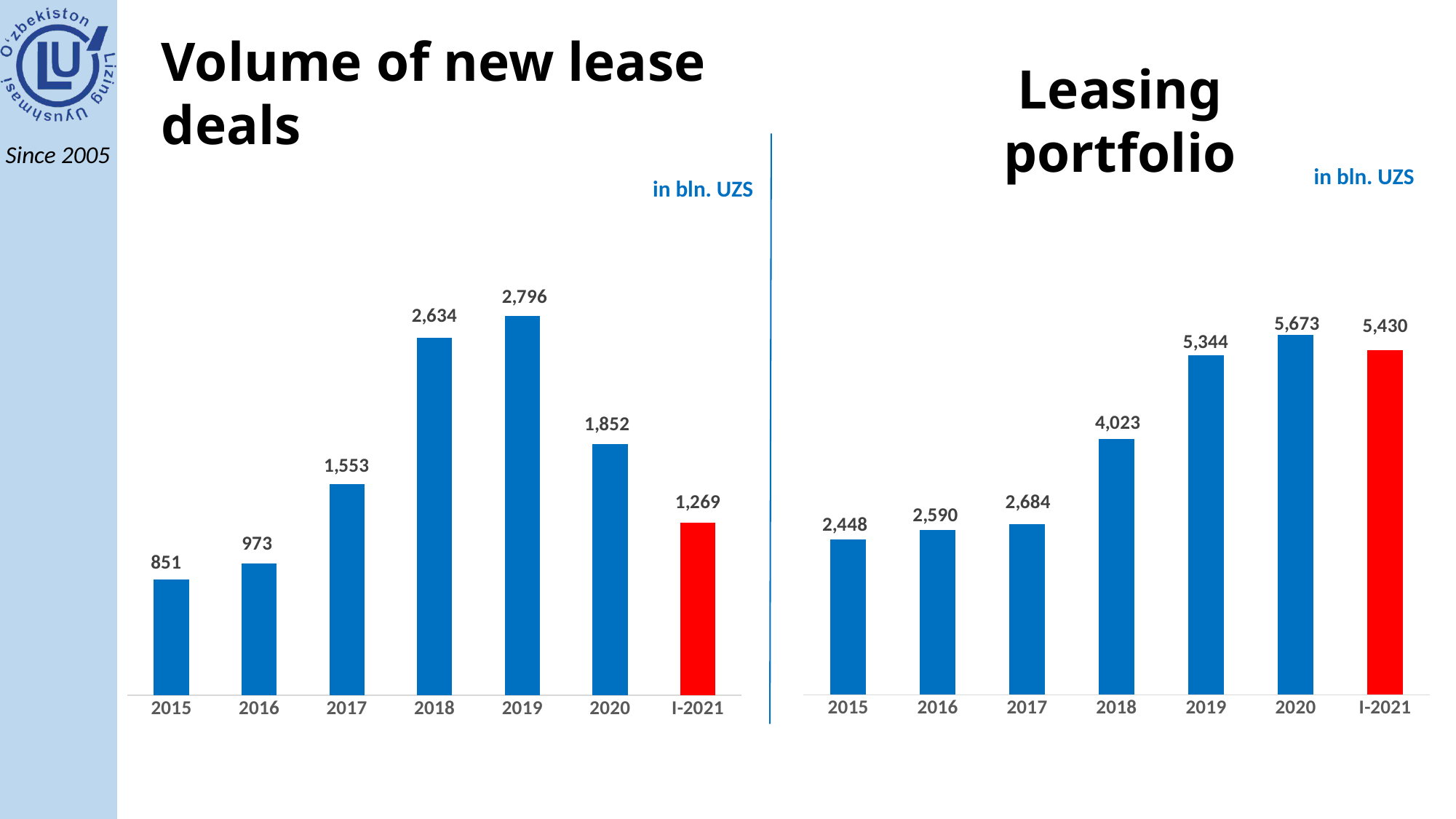
In the 'Volume of new lease deals' chart, what is the value for 2019? 2,796 In the 'Leasing portfolio' chart, which year has the lowest value? 2015 In the 'Leasing portfolio' chart, which is larger, the value for 2019 or the value for 2018? 2019 In the 'Volume of new lease deals' chart, do the values rise or fall from 2015 to 2019? Rise How many bars are shown in the 'Leasing portfolio' chart? 7 In the 'Volume of new lease deals' chart, which is larger, the value for 2020 or the value for I-2021? 2020 In the 'Leasing portfolio' chart, what is the value for 2018? 4,023 In the 'Leasing portfolio' chart, what is the difference between the 2020 and I-2021 values? 243 In the 'Volume of new lease deals' chart, which year has the highest value? 2019 In the 'Leasing portfolio' chart, what unit is stated for the values? in bln. UZS In the 'Volume of new lease deals' chart, what is the difference between the 2018 and 2017 values? 1,081 What type of chart is the 'Volume of new lease deals' chart? Bar chart